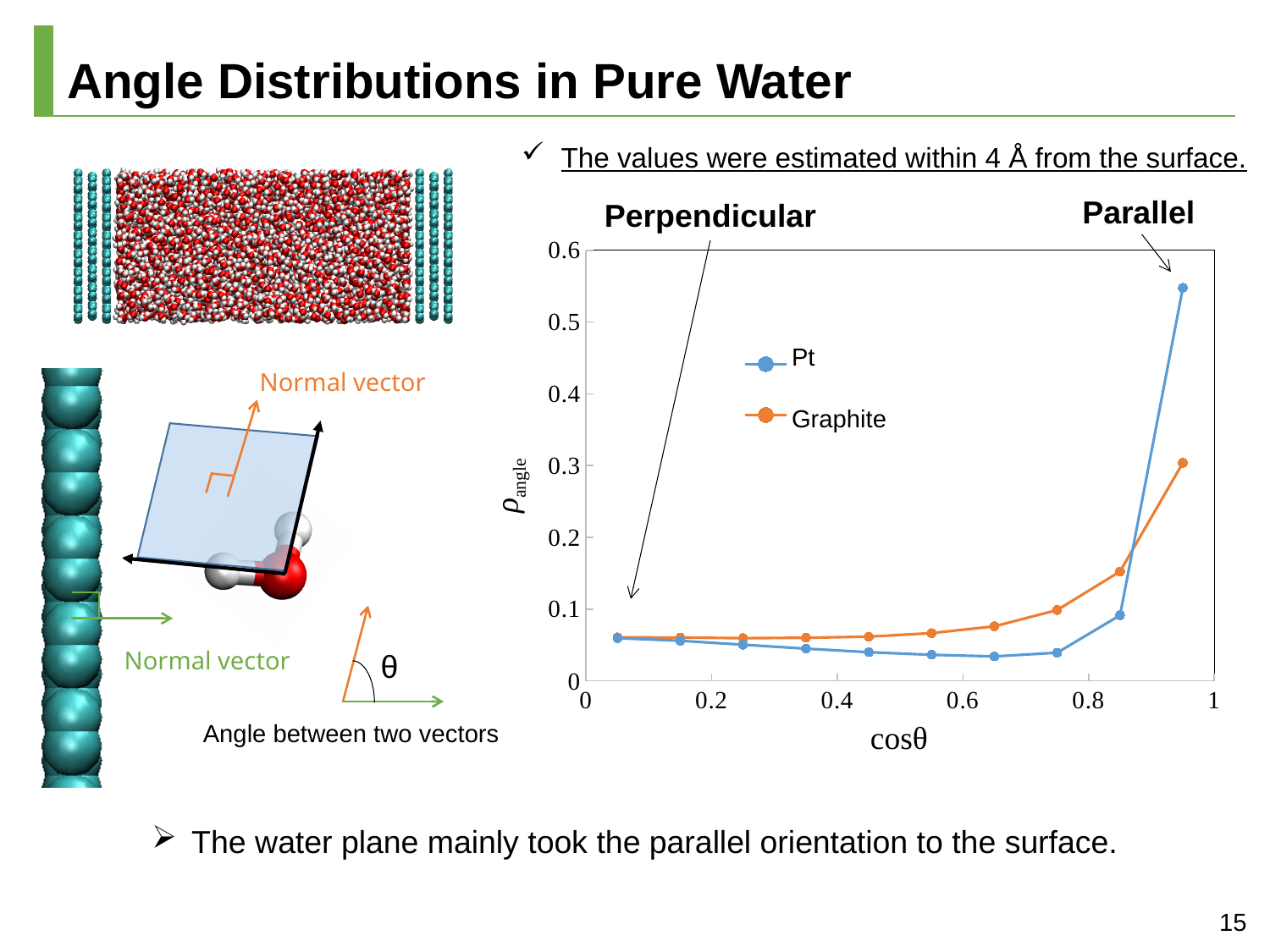
At cosθ = 0.85, which series has the larger value, Pt or Graphite? Graphite Is the Pt value at cosθ = 0.95 greater or less than 0.5? greater At cosθ = 0.95, which series has the larger value, Pt or Graphite? Pt What is the label of the x axis of the chart? cosθ What kind of chart is shown on the slide? line chart Is the Graphite value at cosθ = 0.95 greater or less than 0.4? less Is the Pt value at cosθ = 0.65 greater or less than 0.1? less What are the two series named in the chart legend? Pt and Graphite Do the Graphite values rise or fall as cosθ increases from 0.05 to 0.95? rise How many data points are plotted for the Pt series? 10 How many series does the chart legend list? 2